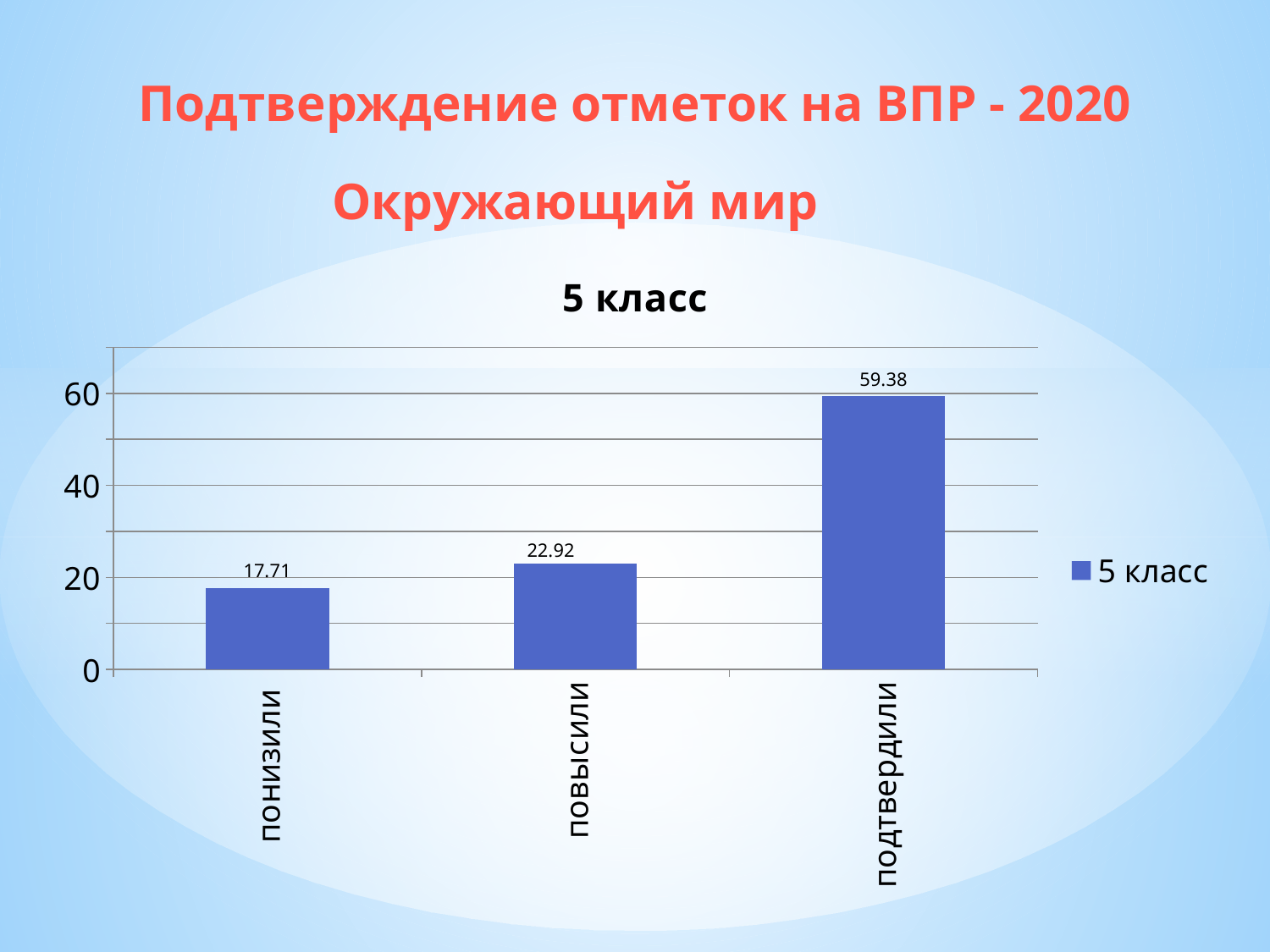
What is the difference between the values for повысили and понизили? 5.21 How many series does the legend list? 1 Is the value for подтвердили greater or less than 40? greater Which is larger, the value for повысили or the value for понизили? повысили Which category has the lowest value? понизили Which category has the highest value? подтвердили What is the difference between the values for подтвердили and повысили? 36.46 What kind of chart is shown on the slide? bar chart What is the value for повысили? 22.92 How many categories are shown on the x axis? 3 What is the value for понизили? 17.71 What is the value for подтвердили? 59.38